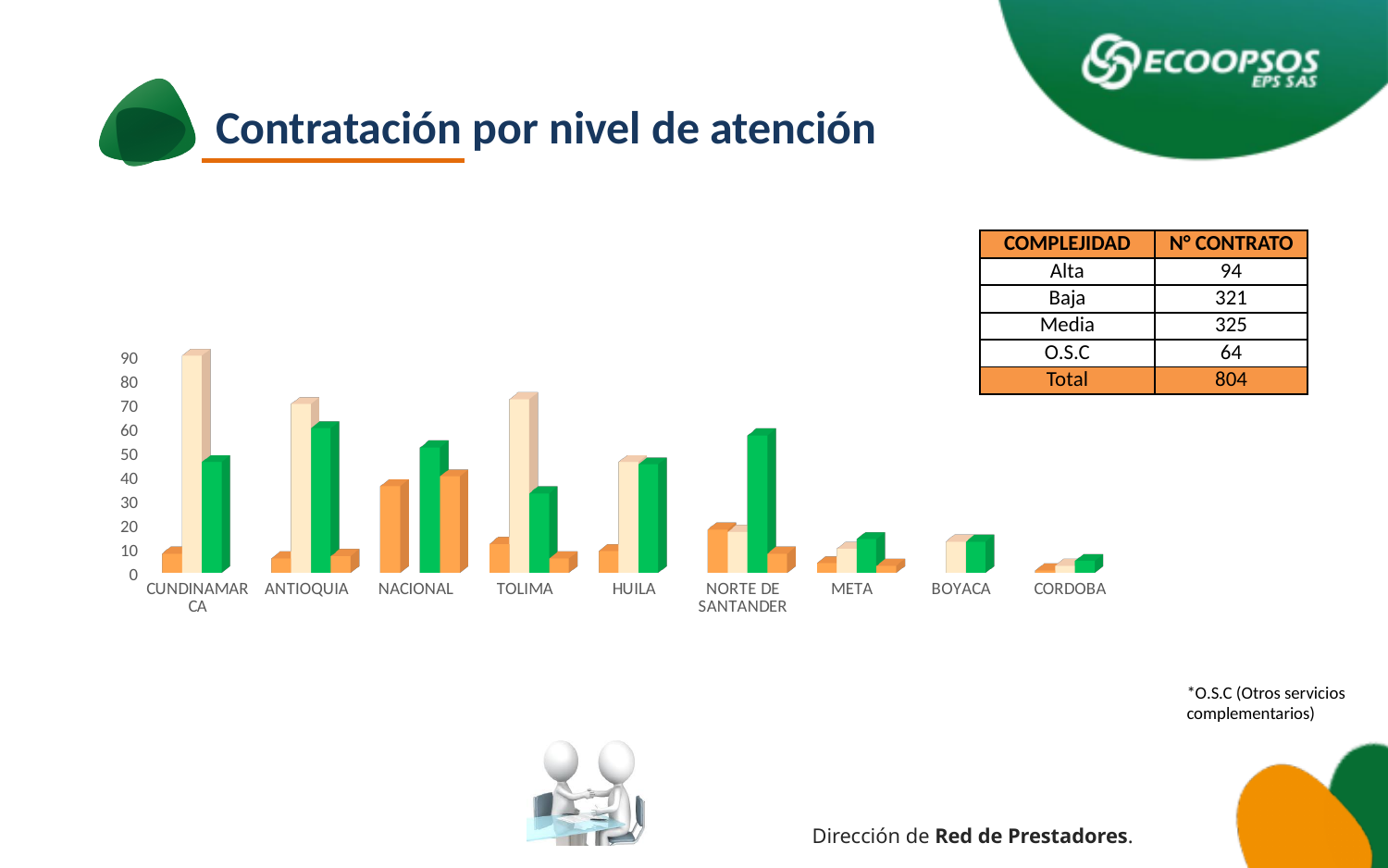
Which category has the smallest bars in the chart? CORDOBA How many categories are shown along the x axis of the chart? 9 Is the tallest bar for CUNDINAMARCA greater or less than 80? greater Is the tallest bar for META greater or less than 30? less Do the tallest bars generally rise or fall moving from left to right along the x axis? fall Which is taller: the green bar for ANTIOQUIA or the green bar for TOLIMA? ANTIOQUIA Is the green bar for NORTE DE SANTANDER greater or less than 50? greater Which category has the tallest bar in the chart? CUNDINAMARCA Which is taller: the tallest bar for CUNDINAMARCA or the tallest bar for ANTIOQUIA? CUNDINAMARCA What kind of chart is shown on the slide? bar chart